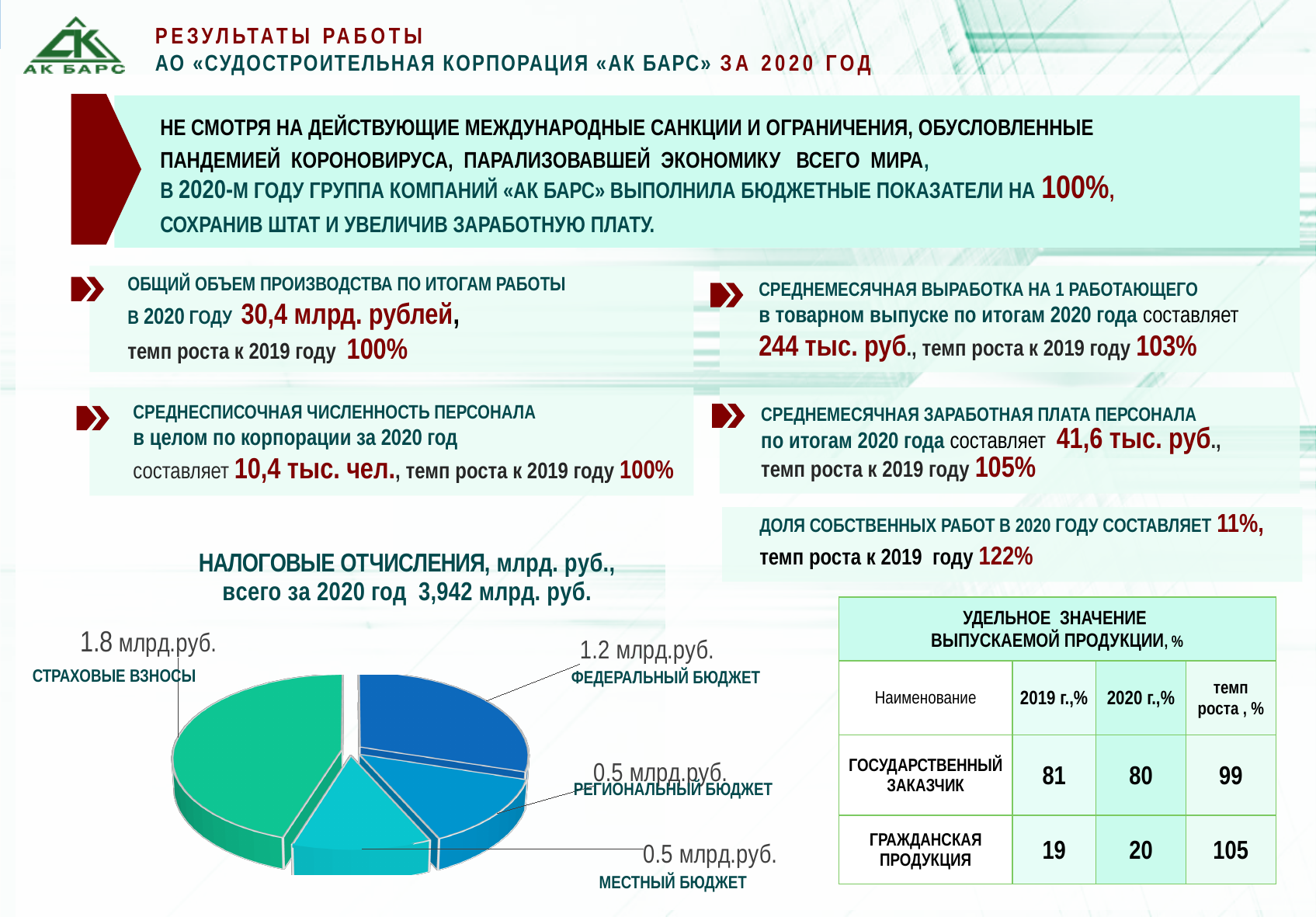
In the tax deductions pie chart, what is the value for СТРАХОВЫЕ ВЗНОСЫ? 1.8 млрд.руб. How many slices does the tax deductions pie chart have? 4 In the tax deductions pie chart, what is the value for РЕГИОНАЛЬНЫЙ БЮДЖЕТ? 0.5 млрд.руб. In the tax deductions pie chart, what is the value for ФЕДЕРАЛЬНЫЙ БЮДЖЕТ? 1.2 млрд.руб. Which slice of the tax deductions pie chart is the largest? СТРАХОВЫЕ ВЗНОСЫ In the tax deductions pie chart, what is the difference between СТРАХОВЫЕ ВЗНОСЫ and ФЕДЕРАЛЬНЫЙ БЮДЖЕТ? 0.6 млрд.руб. In the tax deductions pie chart, what is the value for МЕСТНЫЙ БЮДЖЕТ? 0.5 млрд.руб. According to the pie chart title, what is the total of tax deductions for 2020? 3,942 млрд. руб. What is the title of the pie chart on the slide? НАЛОГОВЫЕ ОТЧИСЛЕНИЯ, млрд. руб., всего за 2020 год 3,942 млрд. руб. In the tax deductions pie chart, which is larger: ФЕДЕРАЛЬНЫЙ БЮДЖЕТ or РЕГИОНАЛЬНЫЙ БЮДЖЕТ? ФЕДЕРАЛЬНЫЙ БЮДЖЕТ What kind of chart is used to show the tax deductions (НАЛОГОВЫЕ ОТЧИСЛЕНИЯ)? Pie chart